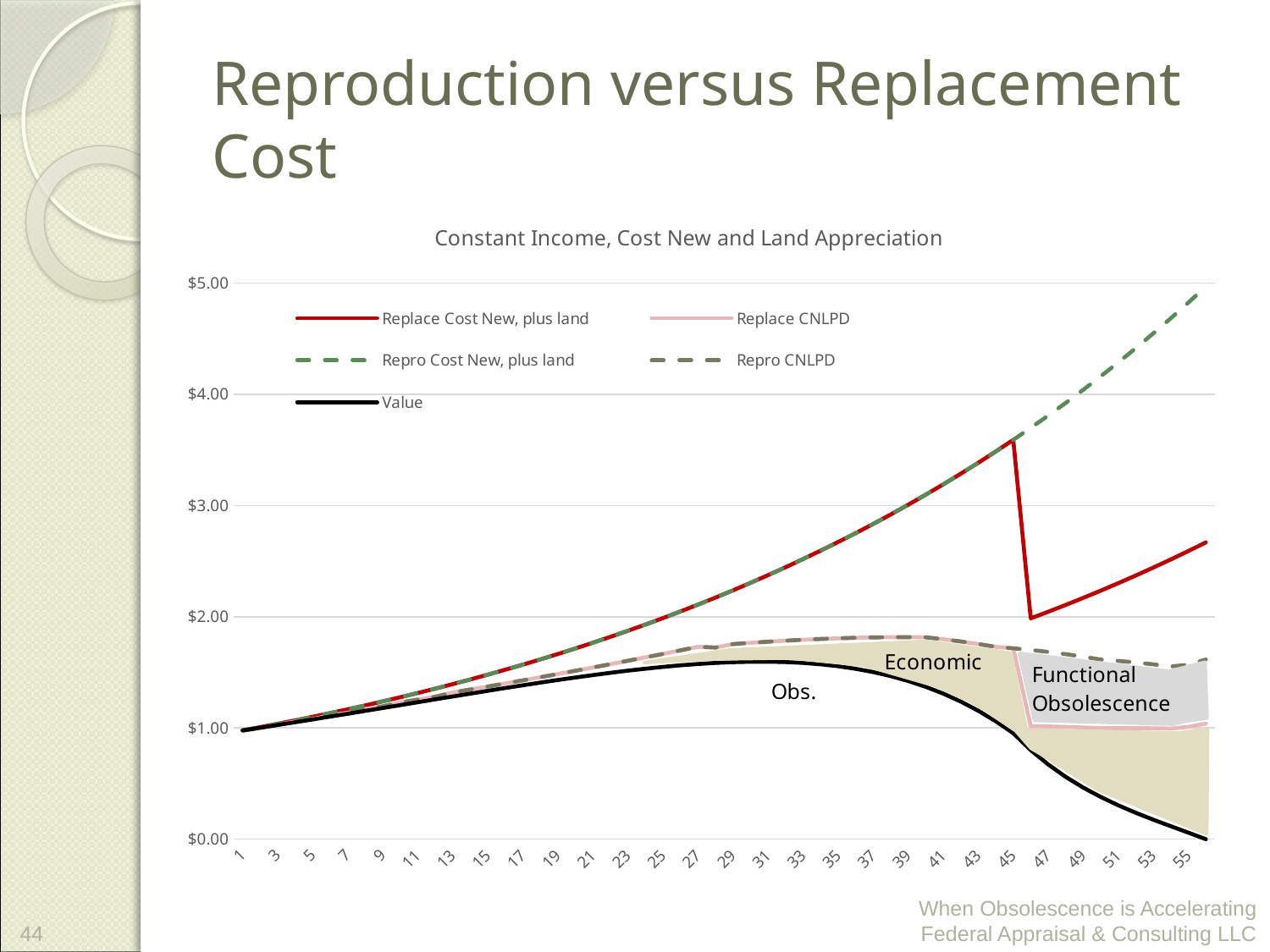
At x = 55, which is higher: Repro Cost New, plus land or Replace Cost New, plus land? Repro Cost New, plus land How many series does the chart legend list? 5 Which series has the highest value at x = 55? Repro Cost New, plus land Is the value of the Value series at x = 55 greater or less than $1.00? less Is the value of the Repro Cost New, plus land series at x = 55 greater or less than $4.00? greater What is the title of the chart? Constant Income, Cost New and Land Appreciation Which series is drawn as a solid black line? Value Does the Repro Cost New, plus land series rise or fall as x increases from 1 to 55? rise What kind of chart is shown on the slide? line chart Is the value of the Repro CNLPD series at x = 55 greater or less than $2.00? less Which series has the lowest value at x = 55? Value